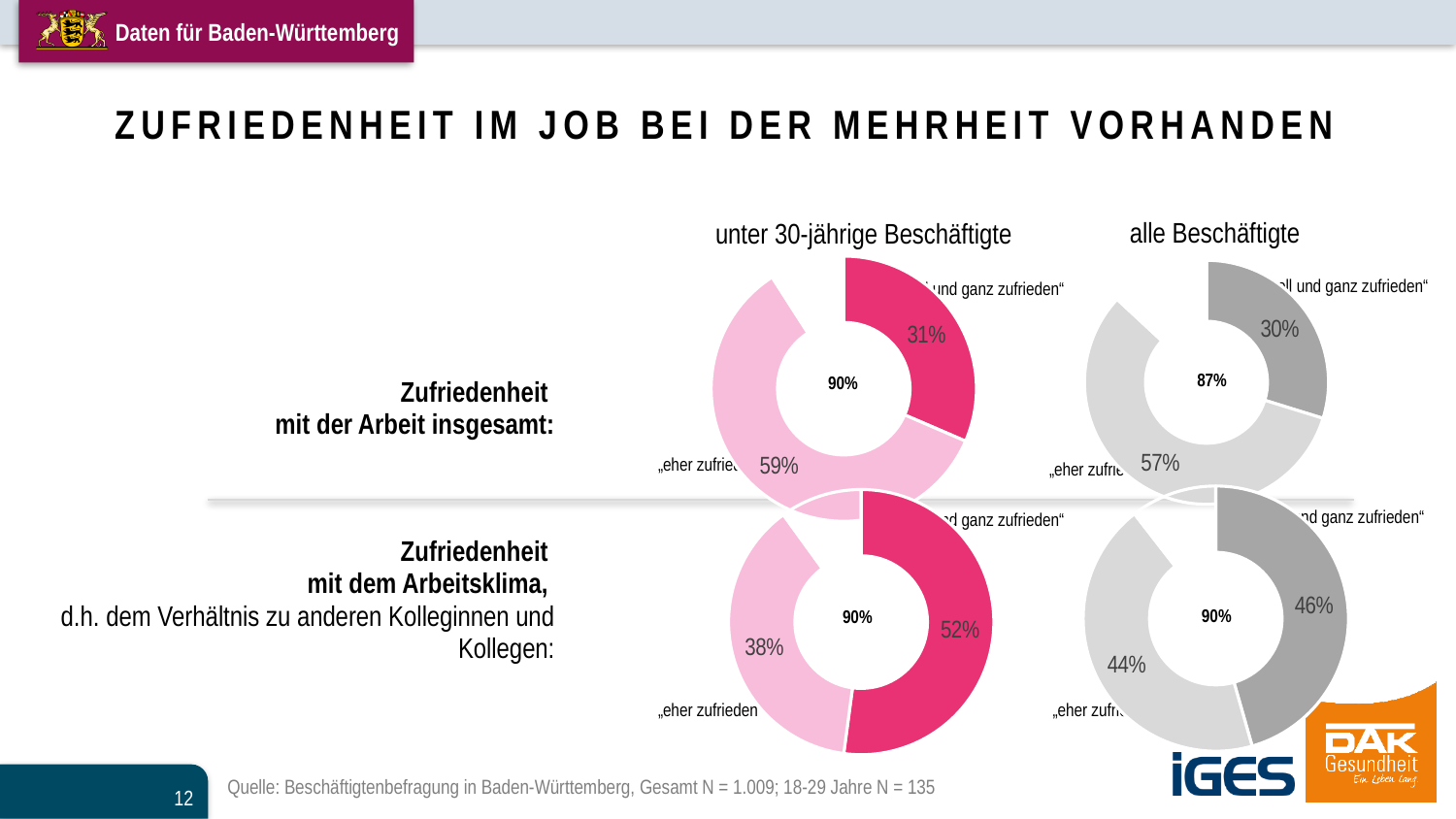
How many donut charts are shown on the slide? 4 For Zufriedenheit mit dem Arbeitsklima, which group has the larger "voll und ganz zufrieden" share: unter 30-jährige Beschäftigte or alle Beschäftigte? unter 30-jährige Beschäftigte In the top-right chart (alle Beschäftigte, Zufriedenheit mit der Arbeit insgesamt), what share is "eher zufrieden"? 57% In the top-left chart (unter 30-jährige Beschäftigte, Zufriedenheit mit der Arbeit insgesamt), what share is "voll und ganz zufrieden"? 31% In the top-left chart (unter 30-jährige Beschäftigte, Zufriedenheit mit der Arbeit insgesamt), what share is labelled "eher zufrieden"? 59% What is the difference between the "voll und ganz zufrieden" share for under-30 employees (31%) and all employees (30%) for Zufriedenheit mit der Arbeit insgesamt? 1 percentage point In the bottom-left chart (unter 30-jährige Beschäftigte, Arbeitsklima), which segment is larger: "voll und ganz zufrieden" or "eher zufrieden"? voll und ganz zufrieden In the bottom-left chart (unter 30-jährige Beschäftigte, Zufriedenheit mit dem Arbeitsklima), what share is "voll und ganz zufrieden"? 52% In the bottom-right chart (alle Beschäftigte, Zufriedenheit mit dem Arbeitsklima), what share is "eher zufrieden"? 44% What total percentage is printed in the centre of the top-right chart (alle Beschäftigte, Zufriedenheit mit der Arbeit insgesamt)? 87% What kind of chart is used on this slide to show job satisfaction? Donut (pie) chart What colour are the donut charts for "alle Beschäftigte"? Grey